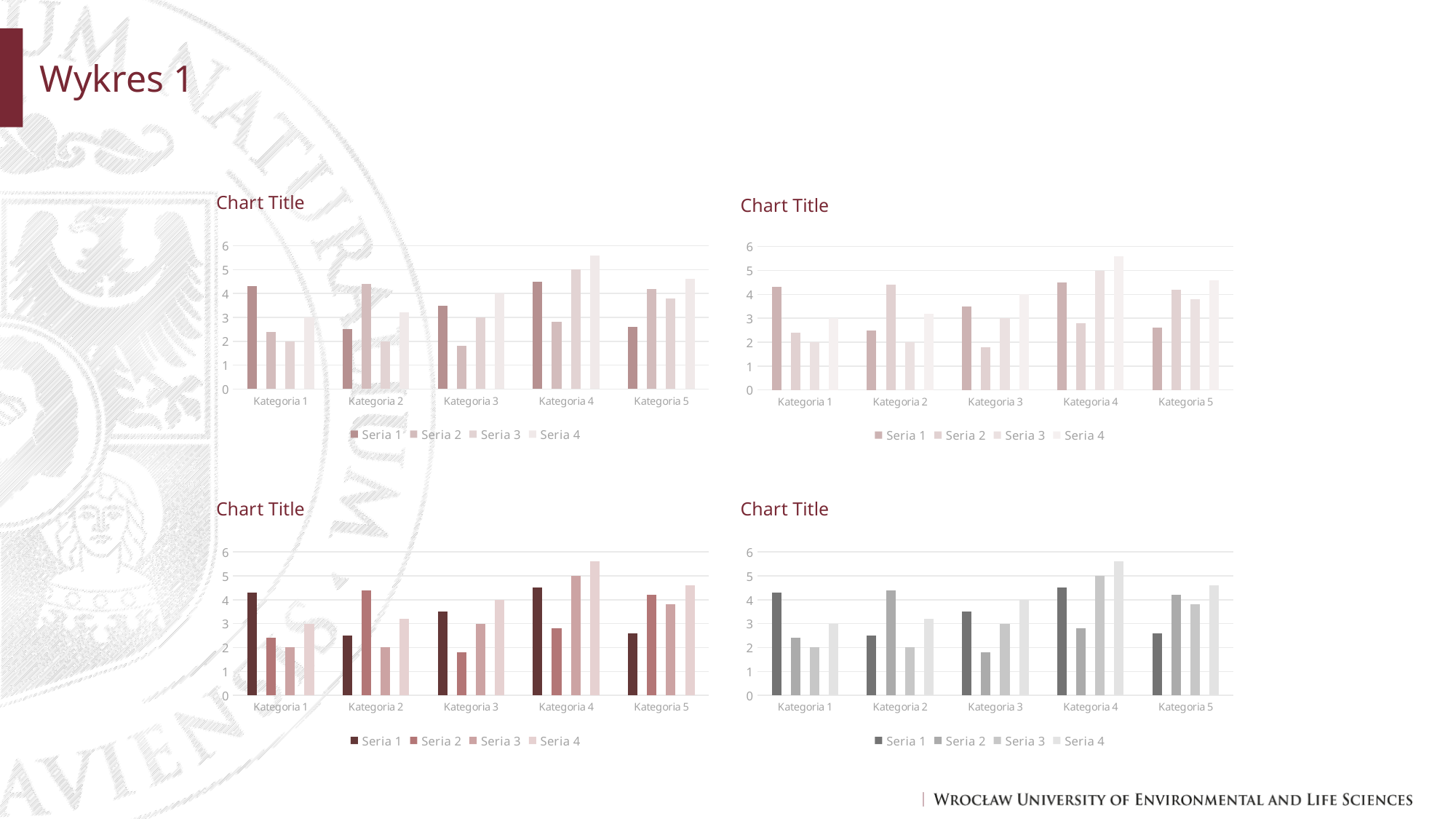
In the top-right chart, which category has the tallest bar for Seria 4? Kategoria 4 In the bottom-left chart, which is larger in Kategoria 2: Seria 1 or Seria 2? Seria 2 How many categories are shown on the x axis of the bottom-right chart? 5 How many series does the legend of the bottom-left chart list? 4 In the bottom-left chart, which category has the lowest value for Seria 2? Kategoria 3 What kind of chart is the top-left chart? bar chart In the top-right chart, which is larger in Kategoria 5: Seria 1 or Seria 4? Seria 4 In the bottom-right chart, is the value for Seria 2 in Kategoria 3 greater or less than 2? less What is the name of the first series in the legend of the top-left chart? Seria 1 In the bottom-right chart, what is the value for Seria 3 in Kategoria 1? 2 In the top-left chart, is the value for Seria 4 in Kategoria 4 greater or less than 5? greater What is the title of the bottom-right chart? Chart Title